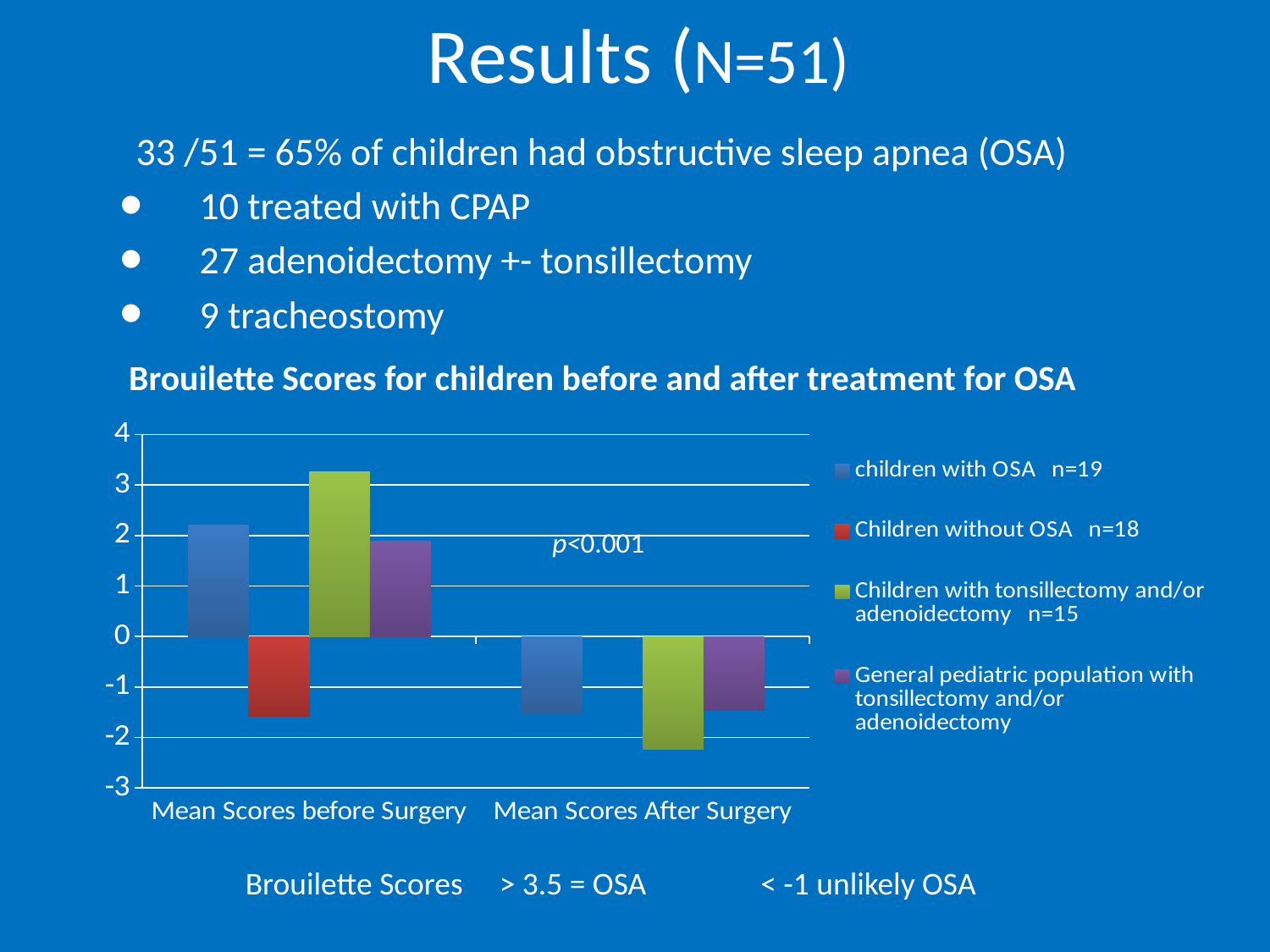
Is the value for Children without OSA for Mean Scores before Surgery greater or less than -1? less Does the value for children with OSA rise or fall from Mean Scores before Surgery to Mean Scores After Surgery? fall What is the title of the chart? Brouilette Scores for children before and after treatment for OSA Which series has the highest bar for Mean Scores before Surgery? Children with tonsillectomy and/or adenoidectomy n=15 Is the value for Children with tonsillectomy and/or adenoidectomy for Mean Scores After Surgery greater or less than -2? less Which series has the lowest bar for Mean Scores After Surgery? Children with tonsillectomy and/or adenoidectomy n=15 Is the value for Children with tonsillectomy and/or adenoidectomy for Mean Scores before Surgery greater or less than 3? greater How many series does the chart legend list? 4 For Mean Scores before Surgery, which is larger: the value for children with OSA or the value for General pediatric population with tonsillectomy and/or adenoidectomy? children with OSA What kind of chart is shown on the slide? bar chart How many categories are shown on the x axis of the chart? 2